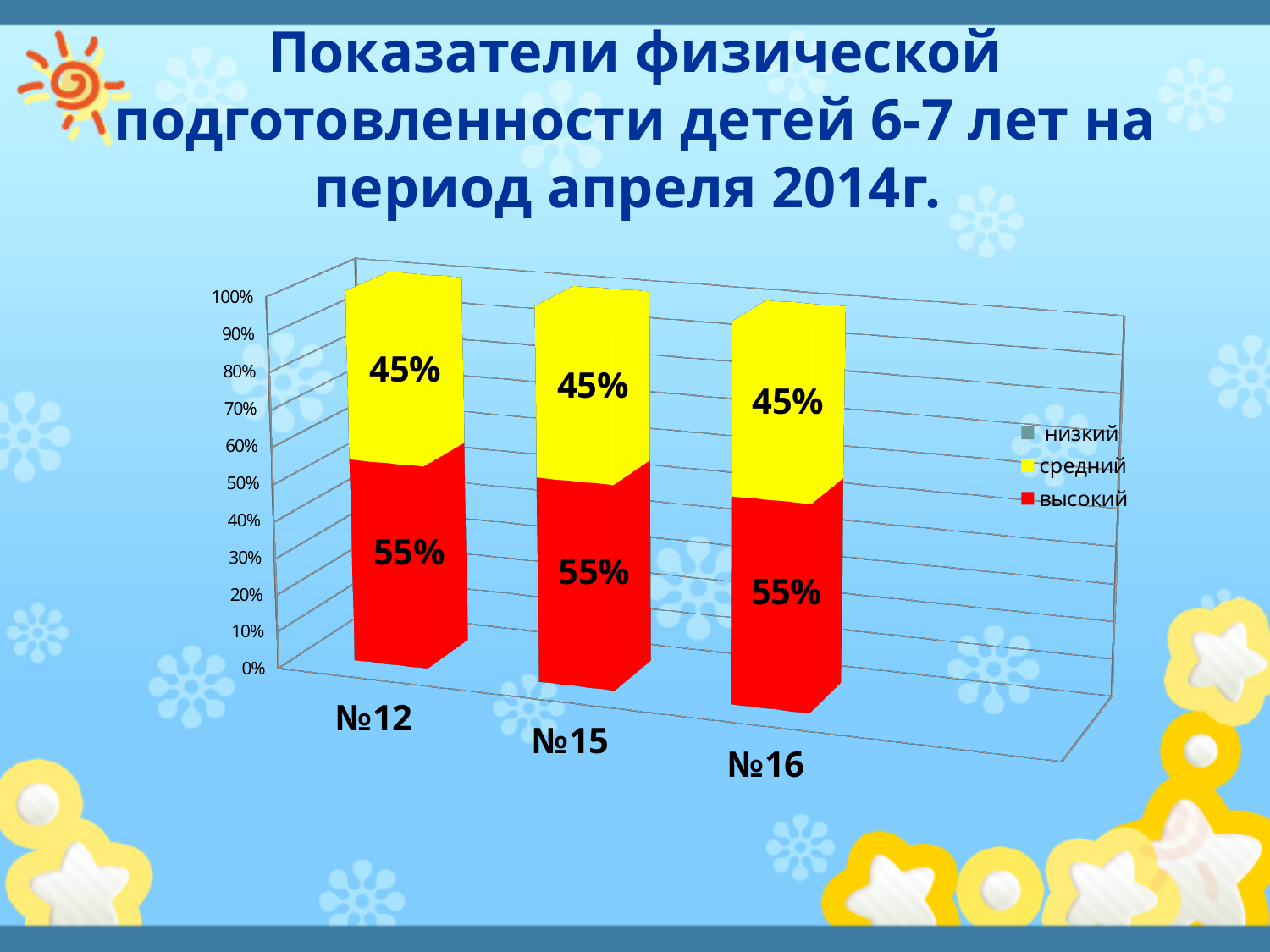
What kind of chart is shown on the slide? stacked bar chart What is the total of the stacked bar for №12? 100% What is the value of the высокий series for №12? 55% What is the value of the средний series for №12? 45% What is the value of the высокий series for №16? 55% How many categories are shown on the x axis? 3 Which legend entry has no visible segment in any bar? низкий How many series does the legend list? 3 What is the value of the средний series for №15? 45% Which is larger for №15: the высокий value or the средний value? высокий What is the difference between the высокий and средний values for №16? 10% Which series is shown in red? высокий